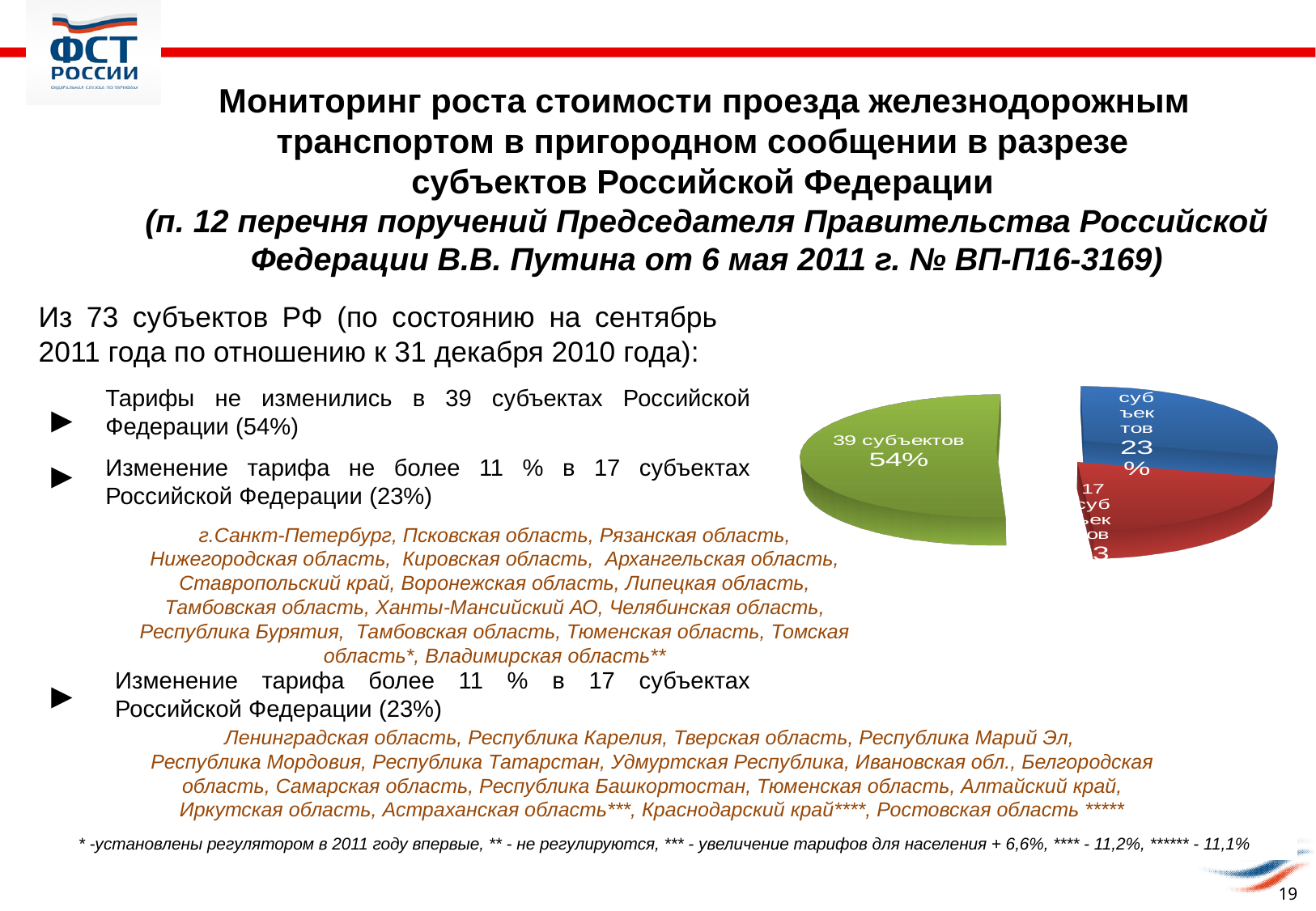
Which slice of the pie chart is the largest? 39 субъектов (54%) What kind of chart is shown on the slide? pie chart What percentage is shown on the green slice of the pie chart? 54% Is the share of the green slice greater or less than 50%? greater What colour is the slice labelled '39 субъектов 54%'? green What is the difference in percentage points between the green slice (54%) and the blue slice (23%)? 31 How many slices does the pie chart have? 3 Is the green slice of the pie chart larger or smaller than the blue slice? larger How many subjects does the green slice of the pie chart represent? 39 субъектов What percentage is shown on the blue slice of the pie chart? 23% Is the share of the blue slice greater or less than 50%? less